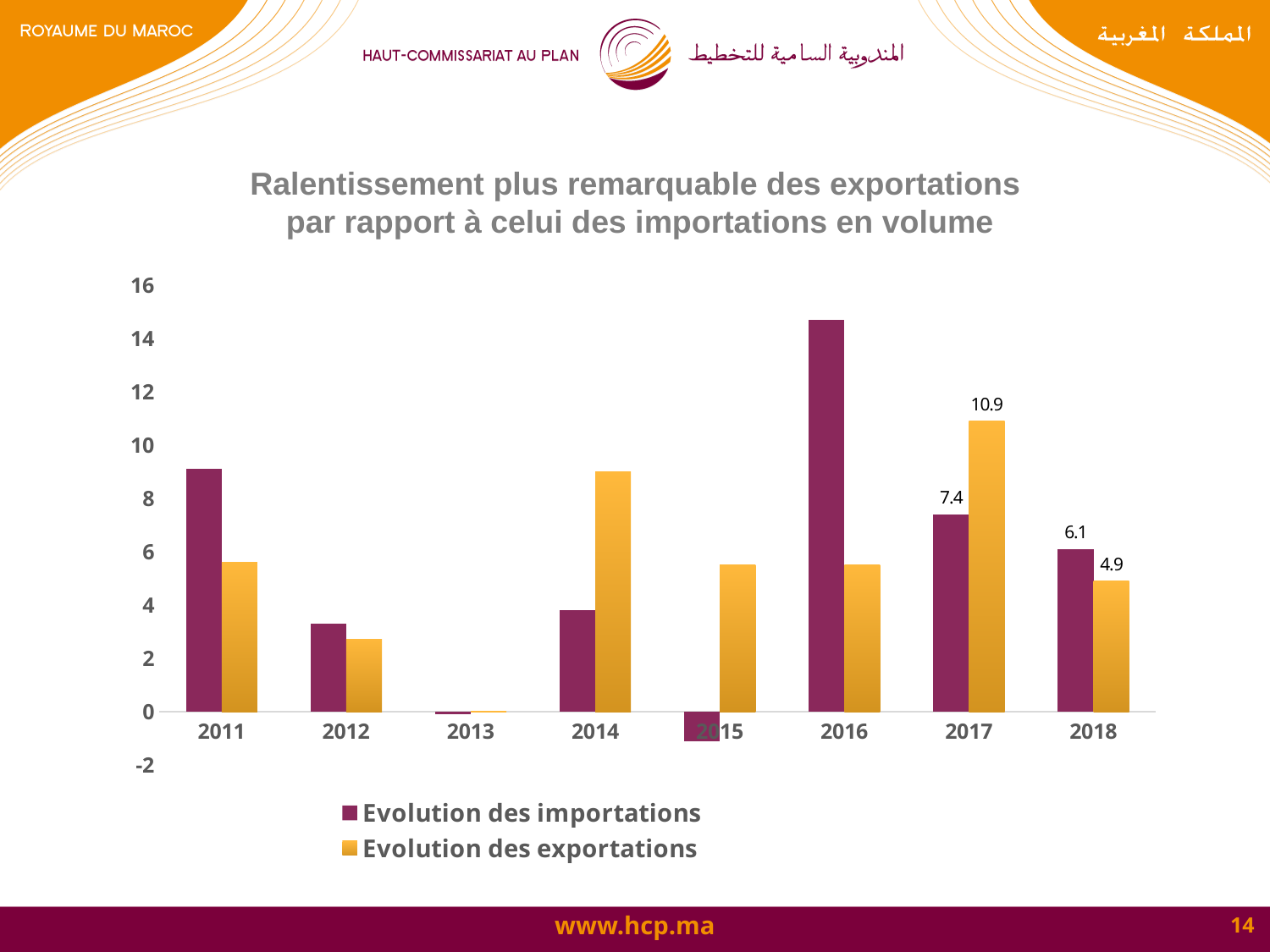
How many years are shown on the x axis? 8 How many series does the legend list? 2 What is the value of Evolution des exportations for 2017? 10.9 Is the value of Evolution des exportations for 2014 greater or less than 8? greater What is the value of Evolution des importations for 2017? 7.4 In 2018, which is larger: Evolution des importations or Evolution des exportations? Evolution des importations What is the value of Evolution des exportations for 2018? 4.9 Is the value of Evolution des importations for 2016 greater or less than 14? greater In which year is Evolution des importations highest? 2016 What kind of chart is shown on the slide? Bar chart What is the difference between Evolution des exportations and Evolution des importations in 2017? 3.5 In which year is Evolution des importations lowest? 2015